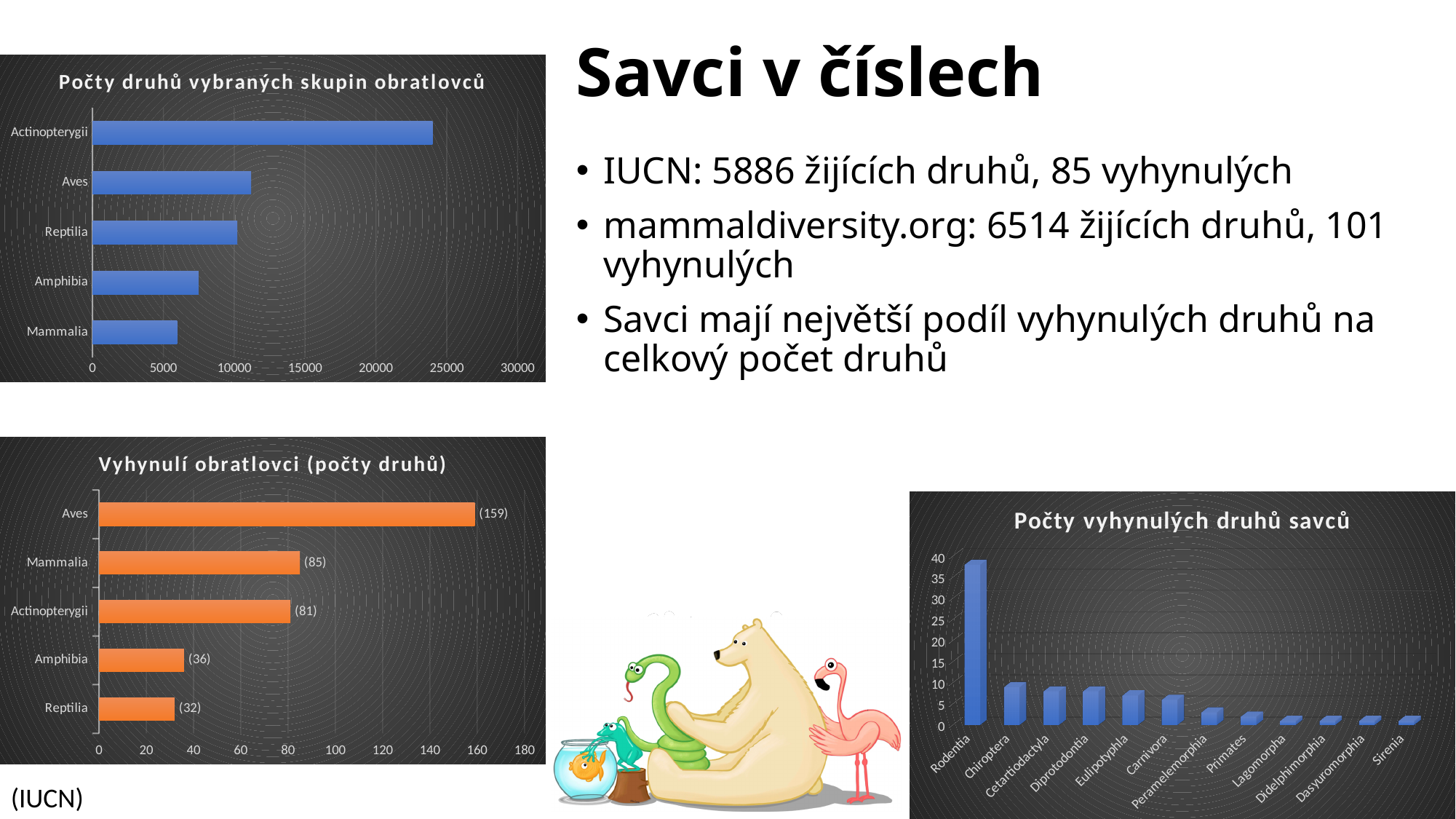
In the chart titled 'Vyhynulí obratlovci (počty druhů)', which is larger, the value for Mammalia or the value for Actinopterygii? Mammalia In the chart titled 'Počty druhů vybraných skupin obratlovců', which category has the lowest value? Mammalia In the chart titled 'Vyhynulí obratlovci (počty druhů)', what is the difference between the values for Aves and Mammalia? 74 How many categories are shown in the chart titled 'Vyhynulí obratlovci (počty druhů)'? 5 In the chart titled 'Počty druhů vybraných skupin obratlovců', is the value for Actinopterygii greater or less than 20000? greater In the chart titled 'Vyhynulí obratlovci (počty druhů)', what is the value for Amphibia? 36 In the chart titled 'Počty druhů vybraných skupin obratlovců', which category has the highest value? Actinopterygii What kind of chart is the chart titled 'Počty druhů vybraných skupin obratlovců'? bar chart In the chart titled 'Počty vyhynulých druhů savců', which category has the highest value? Rodentia In the chart titled 'Vyhynulí obratlovci (počty druhů)', which category has the lowest value? Reptilia How many categories are shown in the chart titled 'Počty vyhynulých druhů savců'? 12 In the chart titled 'Vyhynulí obratlovci (počty druhů)', what is the value for Aves? 159